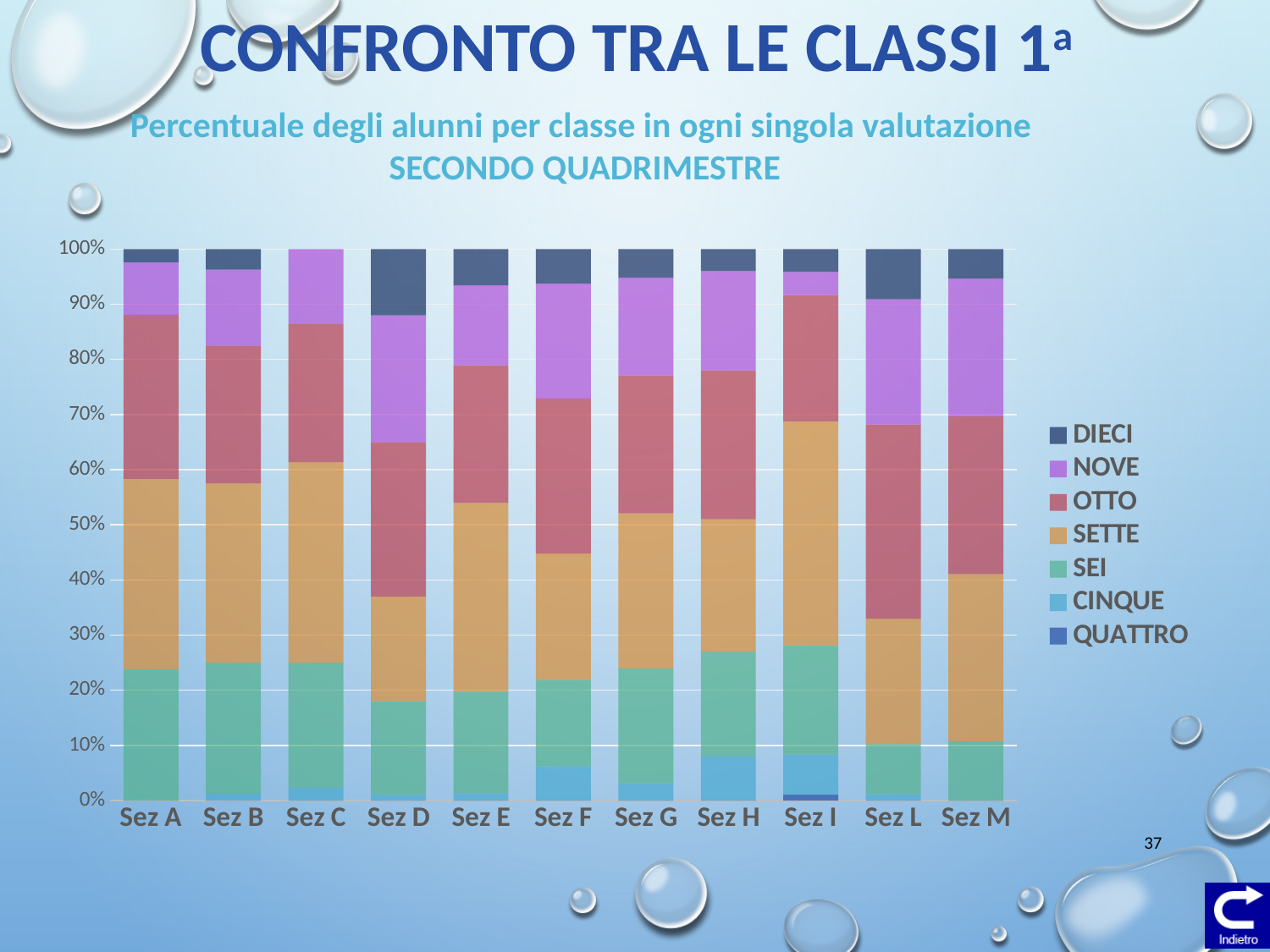
Is the top of the OTTO segment for Sez A greater or less than 80%? greater Which section has the smallest NOVE segment? Sez I Is the top of the SEI segment for Sez D greater or less than 20%? less Is the top of the SETTE segment for Sez I greater or less than 60%? greater Which section has the larger DIECI segment, Sez D or Sez A? Sez D What is the subtitle describing what the chart shows? Percentuale degli alunni per classe in ogni singola valutazione Which series is listed first (at the top) in the chart legend? DIECI Which section has the larger SETTE segment, Sez I or Sez L? Sez I How many series does the chart legend list? 7 How many sections (categories) are shown along the x axis of the chart? 11 What kind of chart is shown on the slide? Stacked bar chart